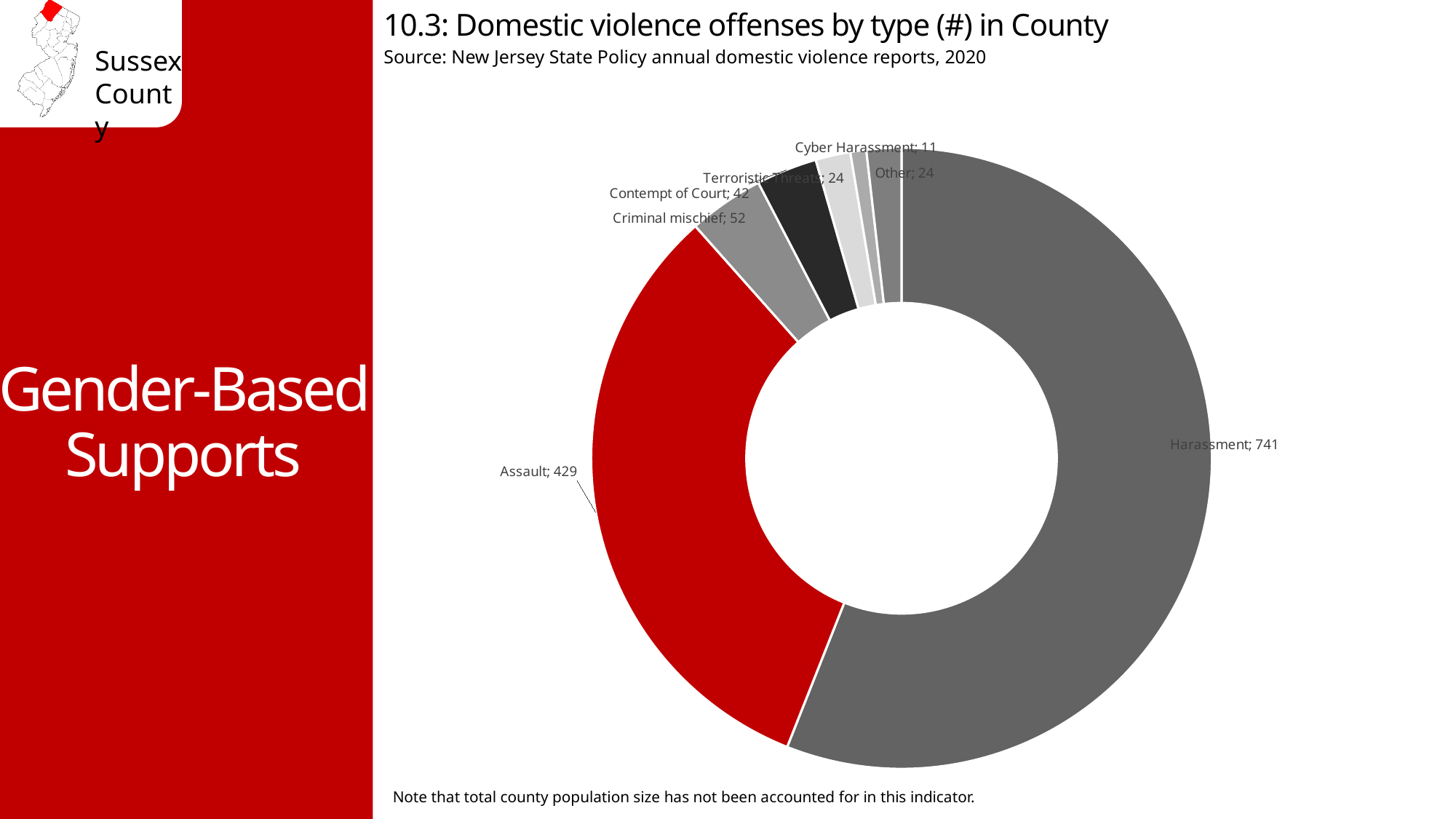
What is the value for Criminal mischief? 52 What is the value for Cyber Harassment? 11 Which is larger, Criminal mischief or Contempt of Court? Criminal mischief How many domestic violence offenses of type Harassment are shown? 741 Which offense type has the smallest number of offenses? Cyber Harassment What is the difference between the Harassment and Assault values? 312 What is the value for Assault? 429 What is the value for Contempt of Court? 42 What kind of chart is shown on the slide? Pie chart (donut) How many offense categories are shown in the chart? 7 What is the source cited for the chart? New Jersey State Policy annual domestic violence reports, 2020 Which offense type has the largest number of offenses? Harassment